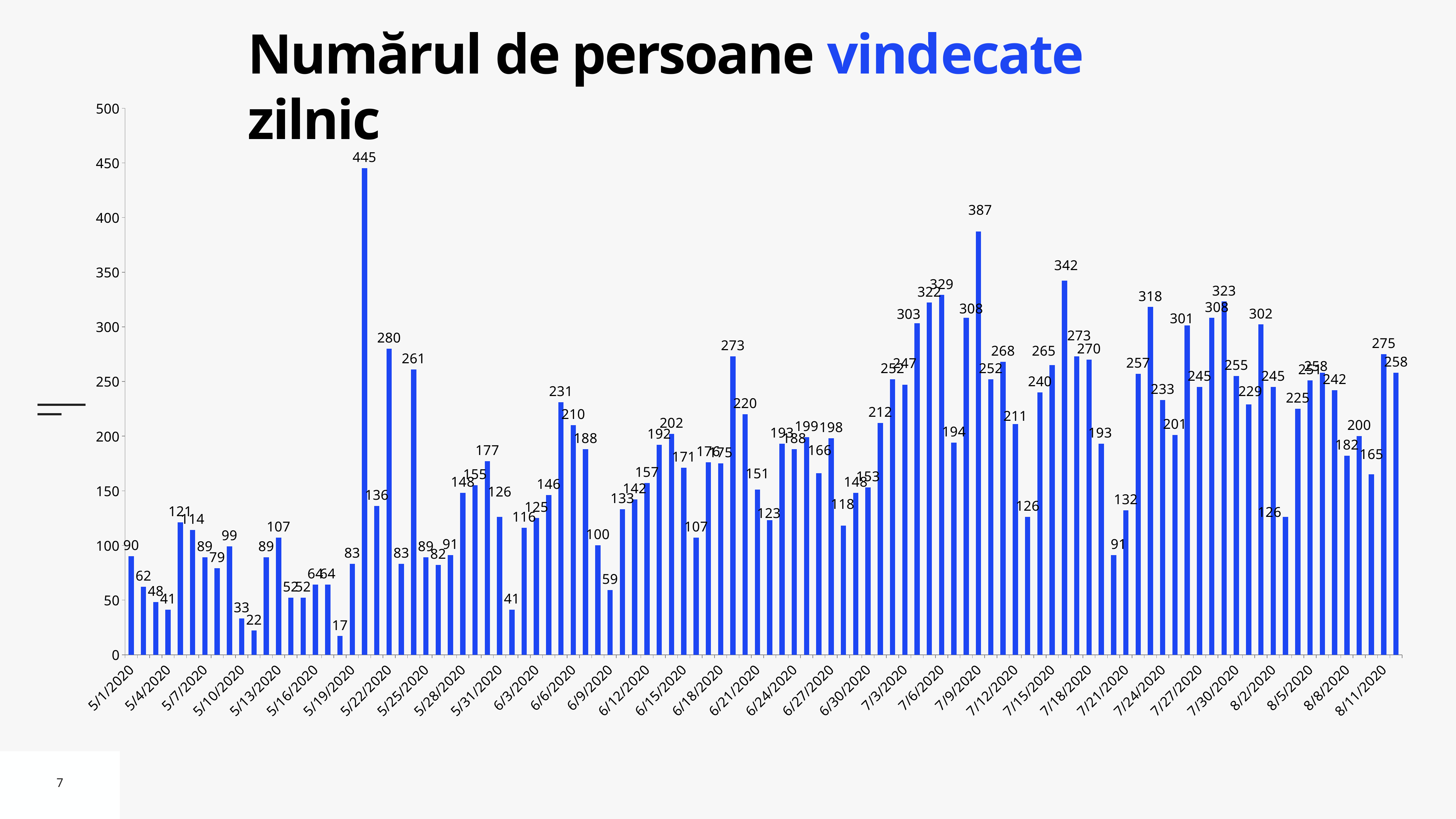
What is the value for 7/21/2020? 132 What is the value for 8/11/2020? 275 What is the highest daily value shown on the chart? 445 Which is larger, the value for 7/9/2020 or the value for 7/6/2020? 7/9/2020 What is the difference between the values for 7/9/2020 and 7/6/2020? 58 What is the value for 6/9/2020? 59 Overall, do the values rise or fall from May to August along the x axis? rise What is the value for 5/1/2020? 90 What kind of chart is shown on the slide? bar chart What is the value for 7/9/2020? 387 What is the lowest daily value shown on the chart? 17 Is the value for 7/9/2020 greater or less than 350? greater